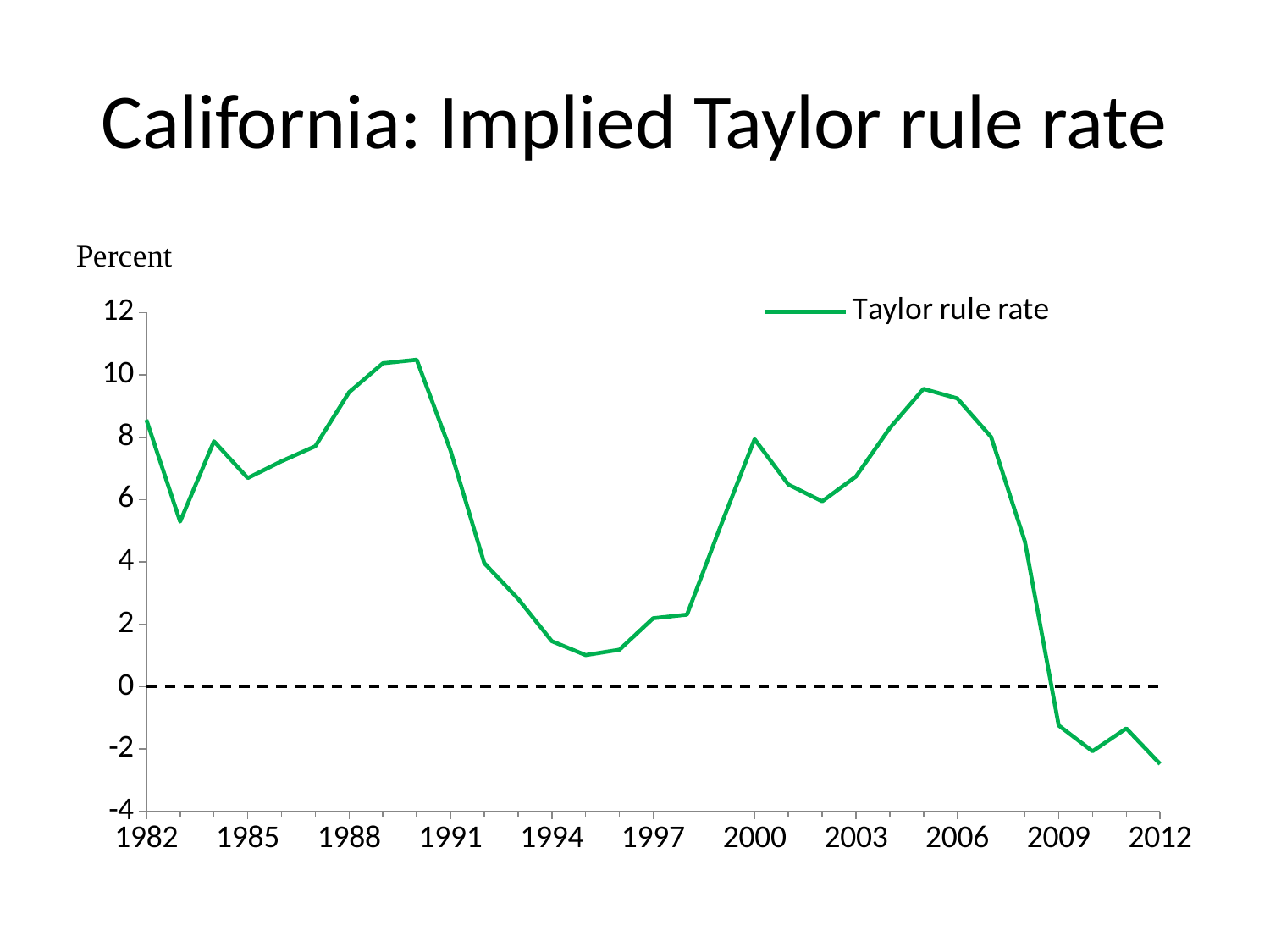
How many series does the legend list? 1 Is the Taylor rule rate for 2005 greater or less than 8? greater Is the Taylor rule rate for 1995 greater or less than 2? less Is the Taylor rule rate for 1983 greater or less than 6? less What kind of chart is shown on the slide? line chart Does the Taylor rule rate rise or fall between 2007 and 2009? fall What unit label is shown above the y axis? Percent Which year has the higher Taylor rule rate, 1990 or 2005? 1990 What is the name of the series shown in the legend? Taylor rule rate Does the Taylor rule rate rise or fall between 1995 and 2000? rise